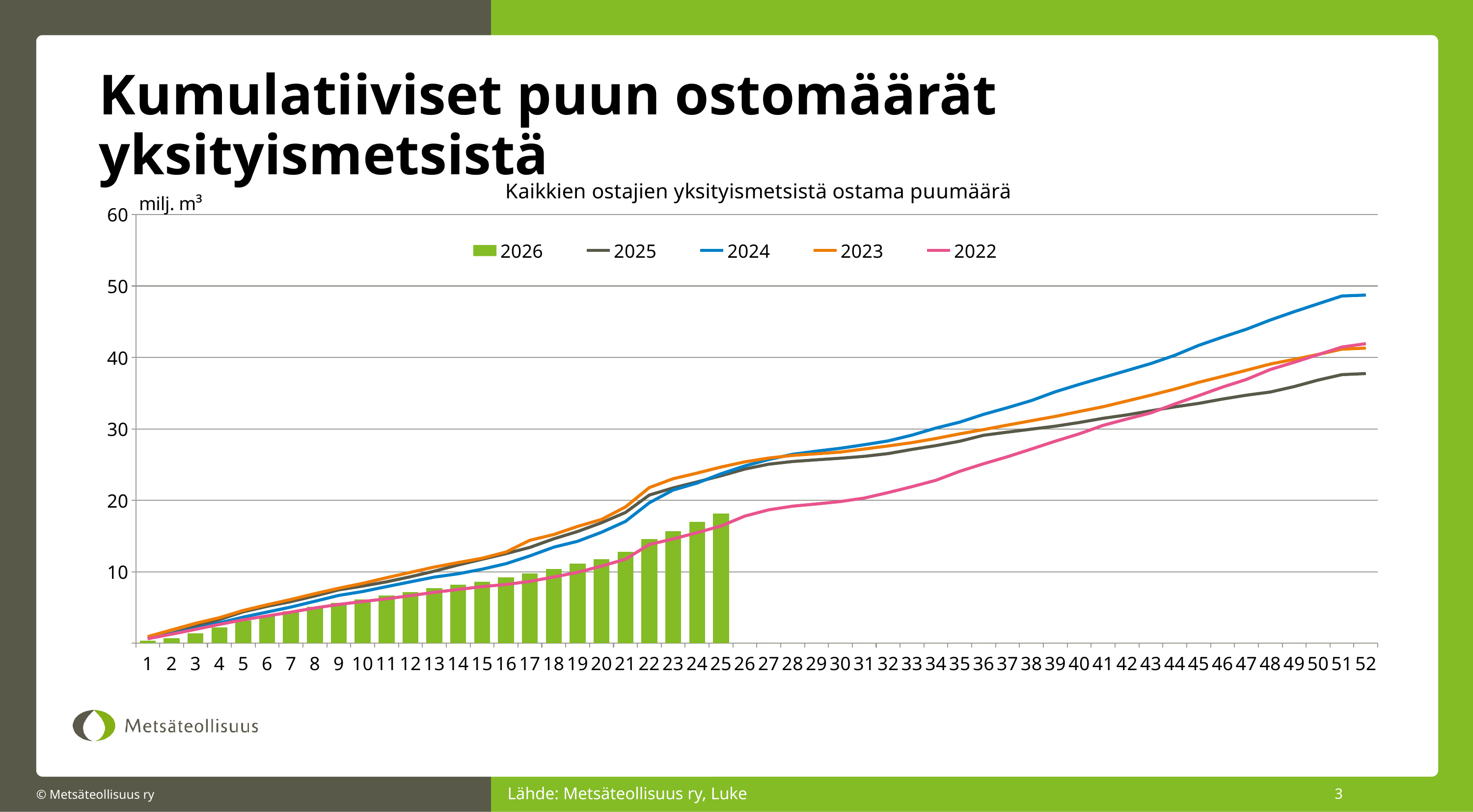
Is the value for 2025 at week 52 greater or less than 40? less How many weeks are shown on the x axis? 52 Is the 2026 bar at week 25 greater or less than 20? less What unit is shown on the y axis? milj. m³ At week 40, which is larger: the 2024 line or the 2022 line? 2024 Which series has the highest value at week 52? 2024 How many series does the legend list? 5 Which series has the lowest value at week 52? 2025 What kind of chart is this? Combined bar and line chart Up to which week are bars plotted for the 2026 series? 25 Is the value for 2024 at week 52 greater or less than 40? greater Do the line series rise or fall along the x axis? rise